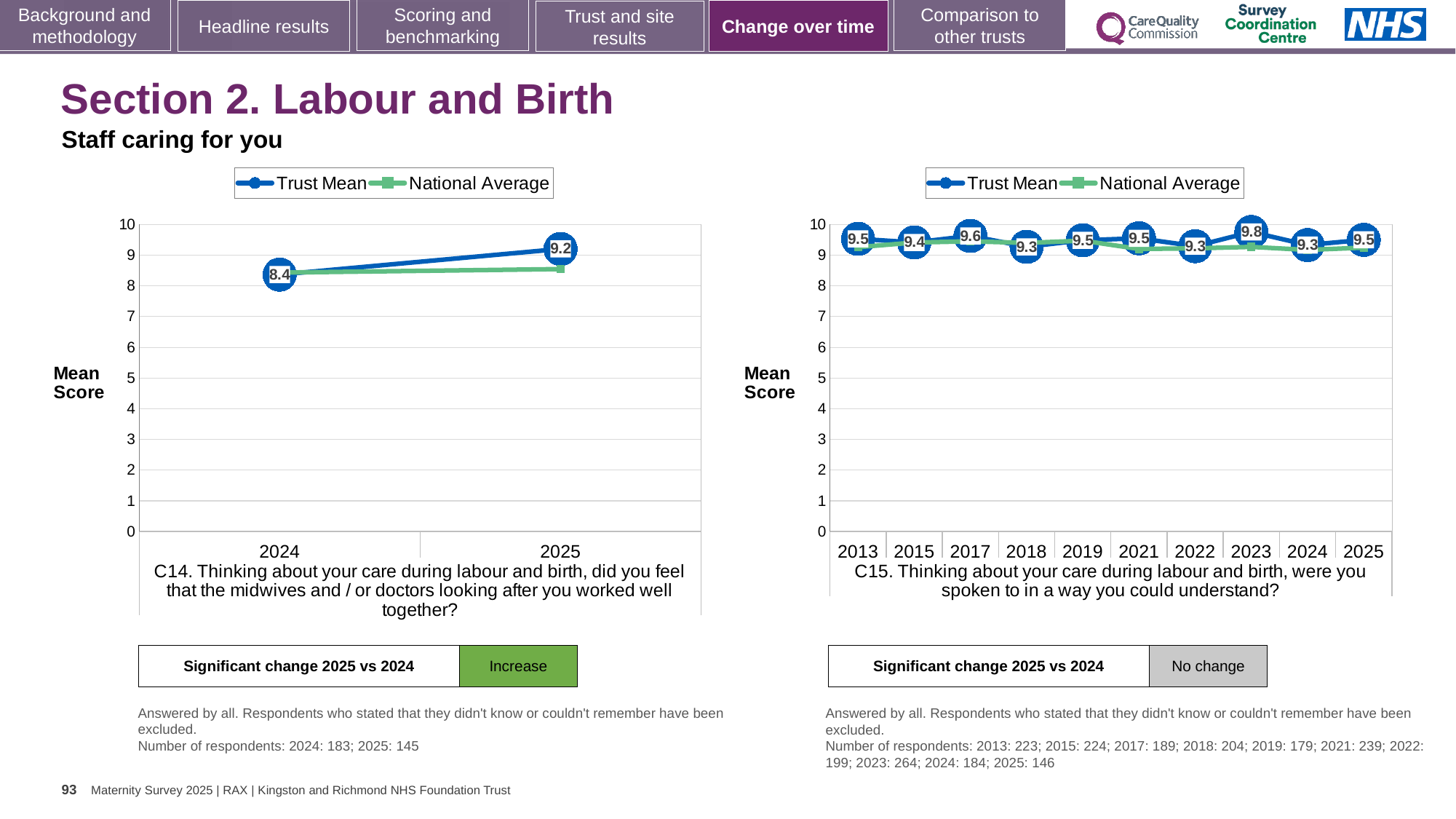
In the C15 chart on the right, which year has the highest Trust Mean? 2023 In the C15 chart on the right, what is the Trust Mean for 2025? 9.5 In the C15 chart on the right, what is the difference between the Trust Mean in 2023 and in 2024? 0.5 In the C14 chart on the left, does the Trust Mean rise or fall from 2024 to 2025? rise What type of chart is the C15 chart on the right? line chart In the C14 chart on the left, what is the Trust Mean for 2025? 9.2 How many series does the legend of the C14 chart on the left list? 2 In the C15 chart on the right, is the Trust Mean for 2018 greater or less than 9? greater In the C15 chart on the right, what is the Trust Mean for 2023? 9.8 In the C14 chart on the left, by how much did the Trust Mean change from 2024 to 2025? 0.8 In the C14 chart on the left, what is the Trust Mean for 2024? 8.4 In the C15 chart on the right, how many years are plotted on the x axis? 10